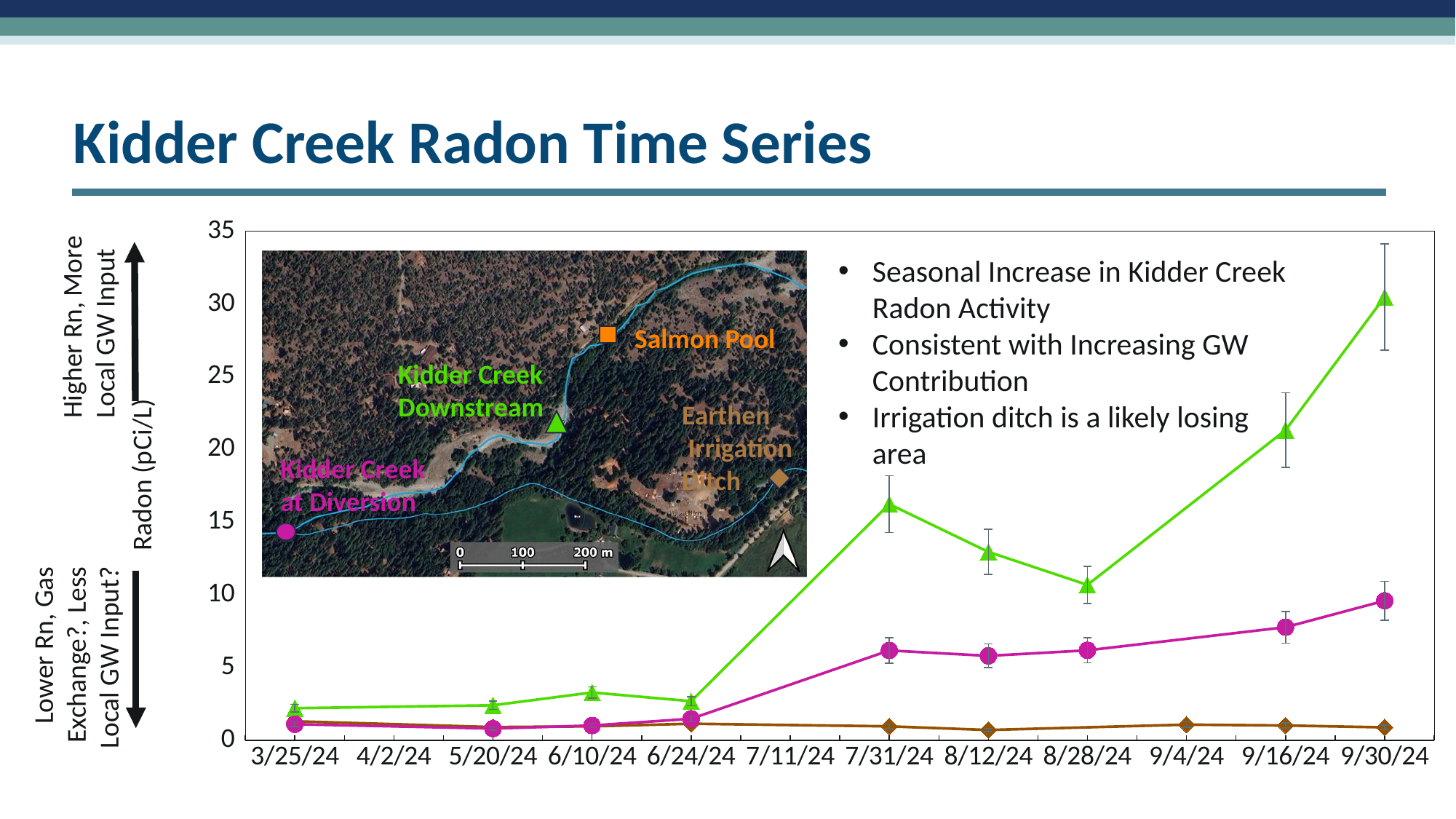
What is the label on the y axis of the chart? Radon (pCi/L) Is the Kidder Creek Downstream value on 9/30/24 greater or less than 25? greater On 8/28/24, which is larger: Kidder Creek Downstream or Kidder Creek at Diversion? Kidder Creek Downstream Is the Kidder Creek at Diversion value on 9/30/24 greater or less than 5? greater Which series has the highest value on 9/30/24? Kidder Creek Downstream For Kidder Creek Downstream, which is larger: the value on 7/31/24 or the value on 8/28/24? 7/31/24 Which series has the lowest value on 9/30/24? Earthen Irrigation Ditch Is the Earthen Irrigation Ditch value on 9/16/24 greater or less than 5? less What kind of chart is shown on the slide? line chart Does the Kidder Creek at Diversion series rise or fall from 6/24/24 to 9/30/24? rise What is the title of the chart? Kidder Creek Radon Time Series